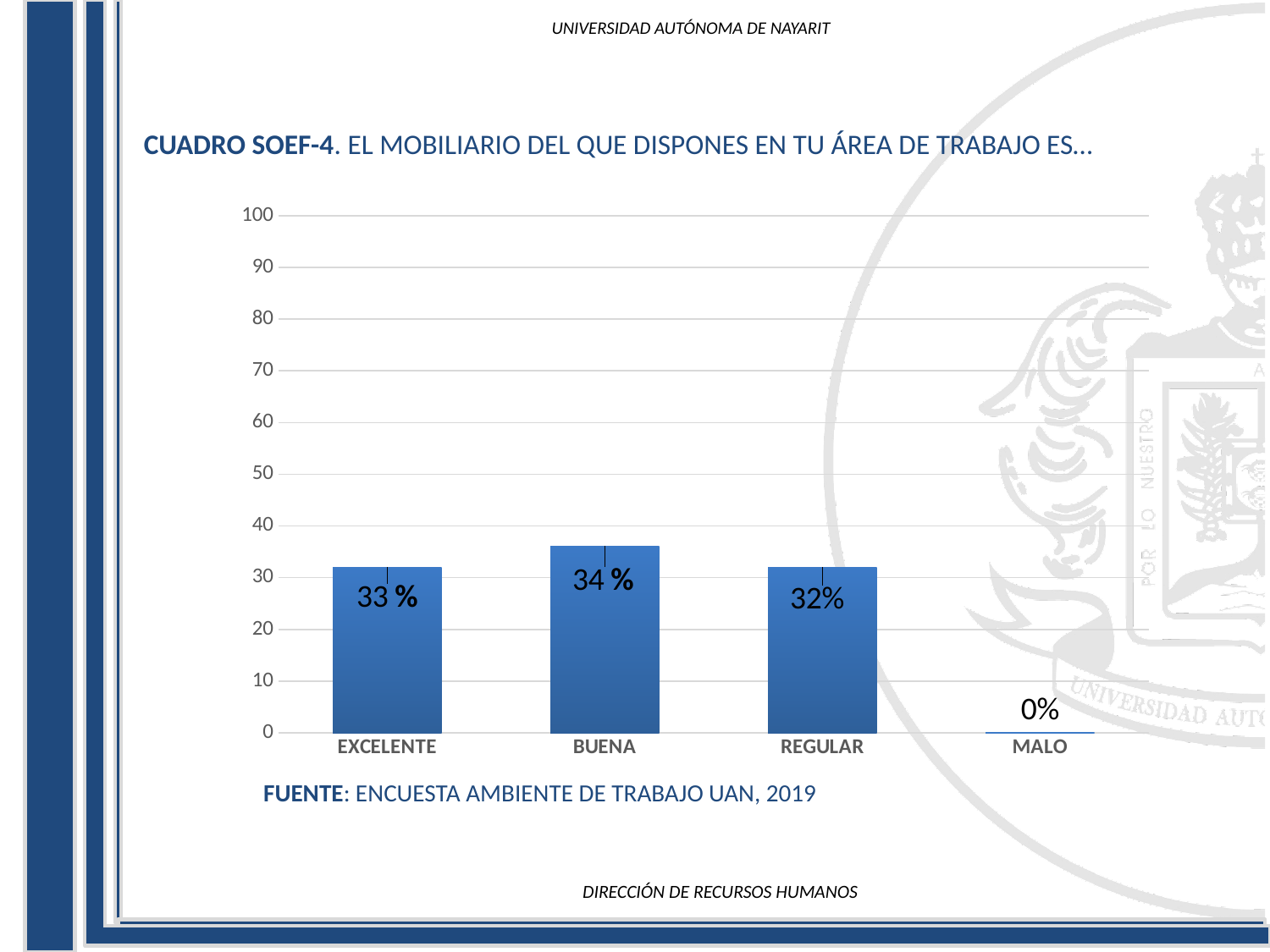
What value is shown for BUENA? 34 % How many categories are shown on the x axis? 4 Is the value for BUENA greater or less than 50? less What kind of chart is shown on the slide? bar chart What value is shown for MALO? 0% What source is cited below the chart? ENCUESTA AMBIENTE DE TRABAJO UAN, 2019 What value is shown for REGULAR? 32% Which category has the highest value? BUENA Which is larger, the value for EXCELENTE or the value for MALO? EXCELENTE What value is shown for EXCELENTE? 33 % Which category has the lowest value? MALO